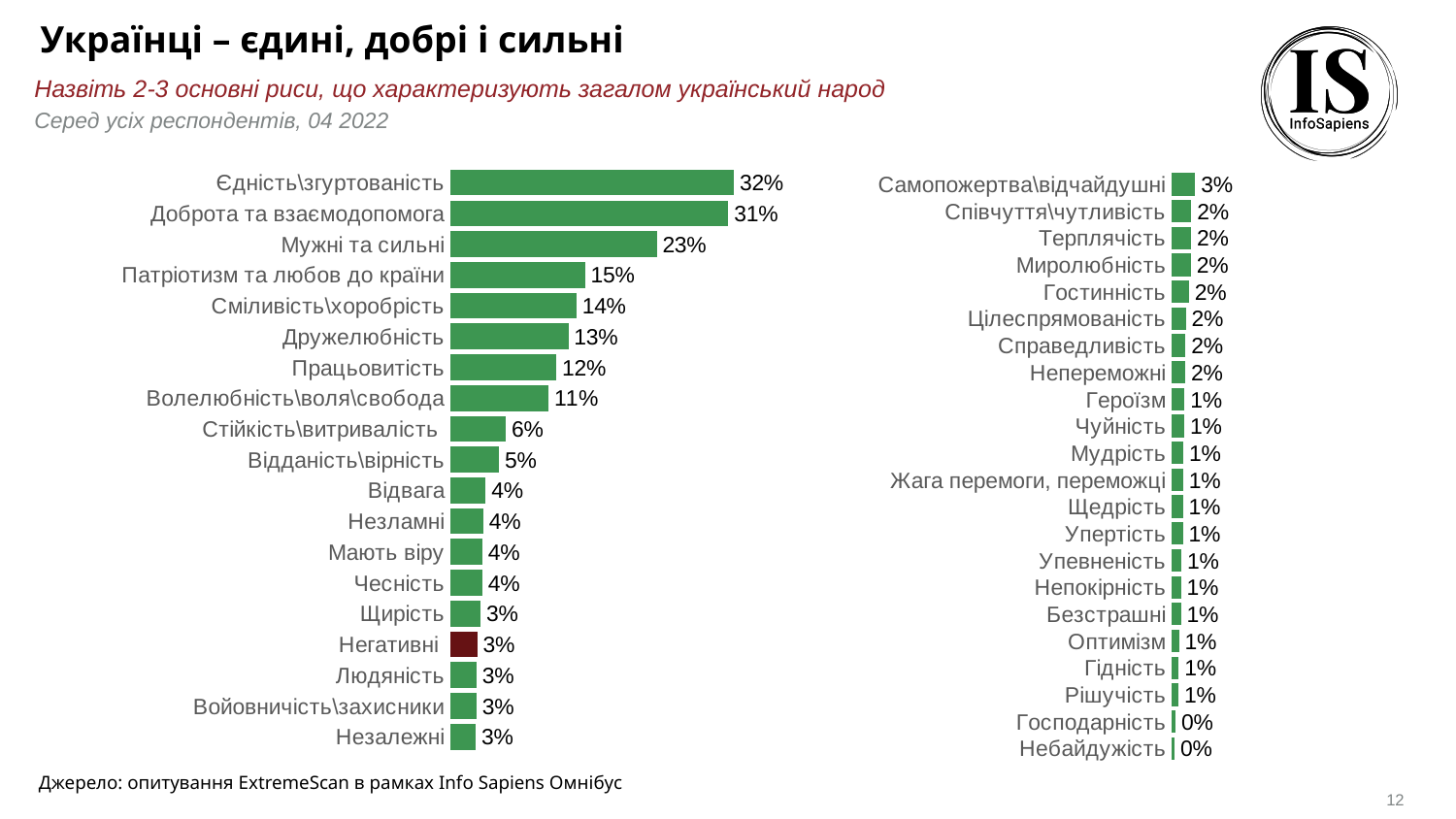
On the left chart, what is the difference between Доброта та взаємодопомога and Мужні та сильні? 8% On the left chart, which is larger: Працьовитість or Волелюбність\воля\свобода? Працьовитість On the right chart, what is the difference between Самопожертва\відчайдушні and Героїзм? 2% On the right chart, how many categories are shown? 22 On the left chart, what is the value for Патріотизм та любов до країни? 15% On the left chart, what is the value for Єдність\згуртованість? 32% On the left chart, how many categories are shown? 19 On the left chart, which category has the highest value? Єдність\згуртованість What type of chart is the left chart? Bar chart On the right chart, what is the value for Самопожертва\відчайдушні? 3% On the left chart, which bar is coloured differently (dark red) from the others? Негативні On the right chart, what is the value for Господарність? 0%